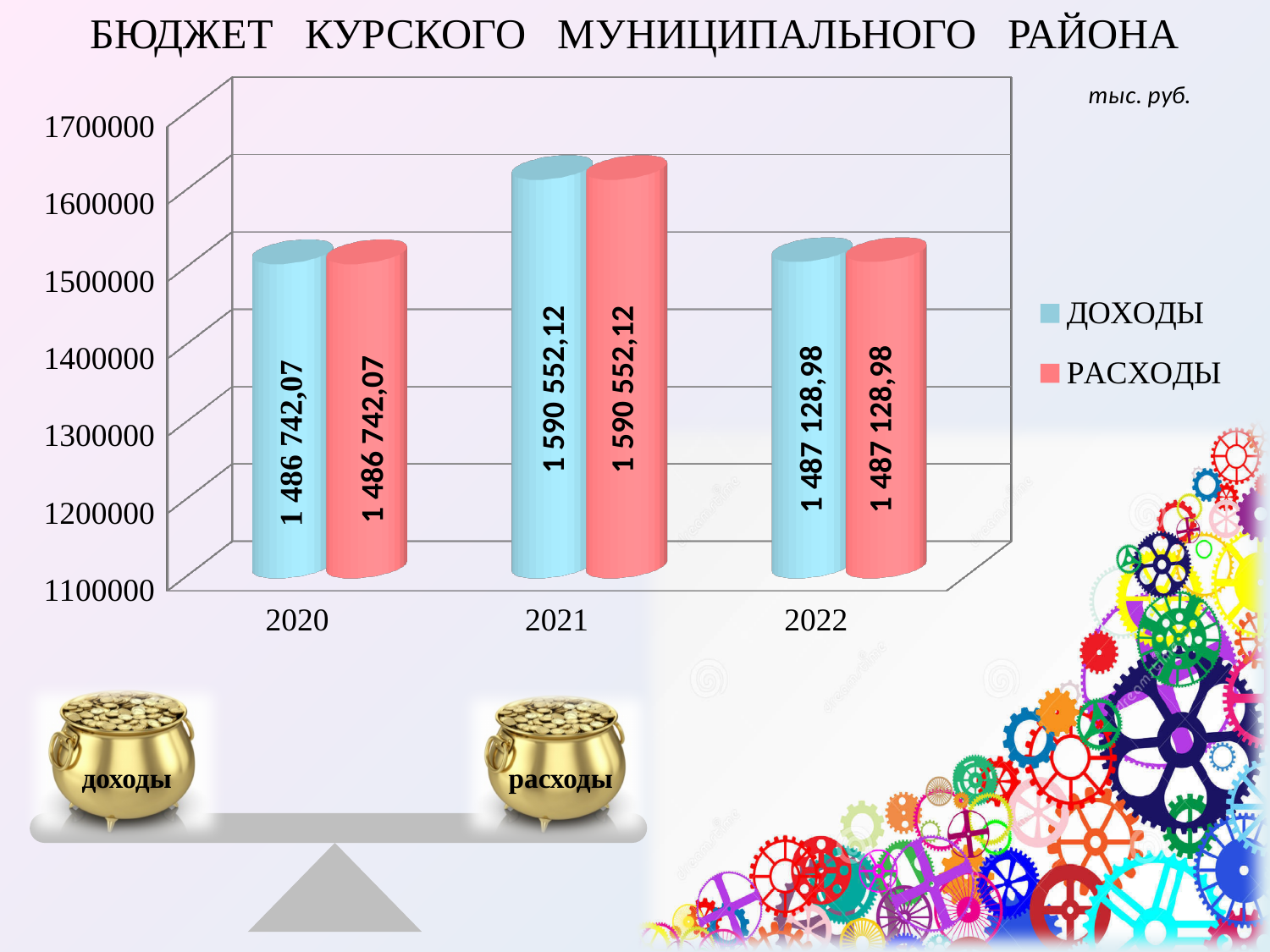
Which is larger: ДОХОДЫ in 2021 or ДОХОДЫ in 2022? ДОХОДЫ in 2021 In which year is ДОХОДЫ highest? 2021 What is the difference between РАСХОДЫ in 2021 and РАСХОДЫ in 2022? 103 423,14 What is the value of ДОХОДЫ for 2020? 1 486 742,07 What is the value of ДОХОДЫ for 2022? 1 487 128,98 What is the difference between ДОХОДЫ in 2021 and ДОХОДЫ in 2020? 103 810,05 How many years are shown on the x axis? 3 What kind of chart is shown on the slide? bar chart How many series does the legend list? 2 Is the value of РАСХОДЫ for 2021 greater or less than 1500000? greater In which year is РАСХОДЫ lowest? 2020 What is the value of РАСХОДЫ for 2021? 1 590 552,12